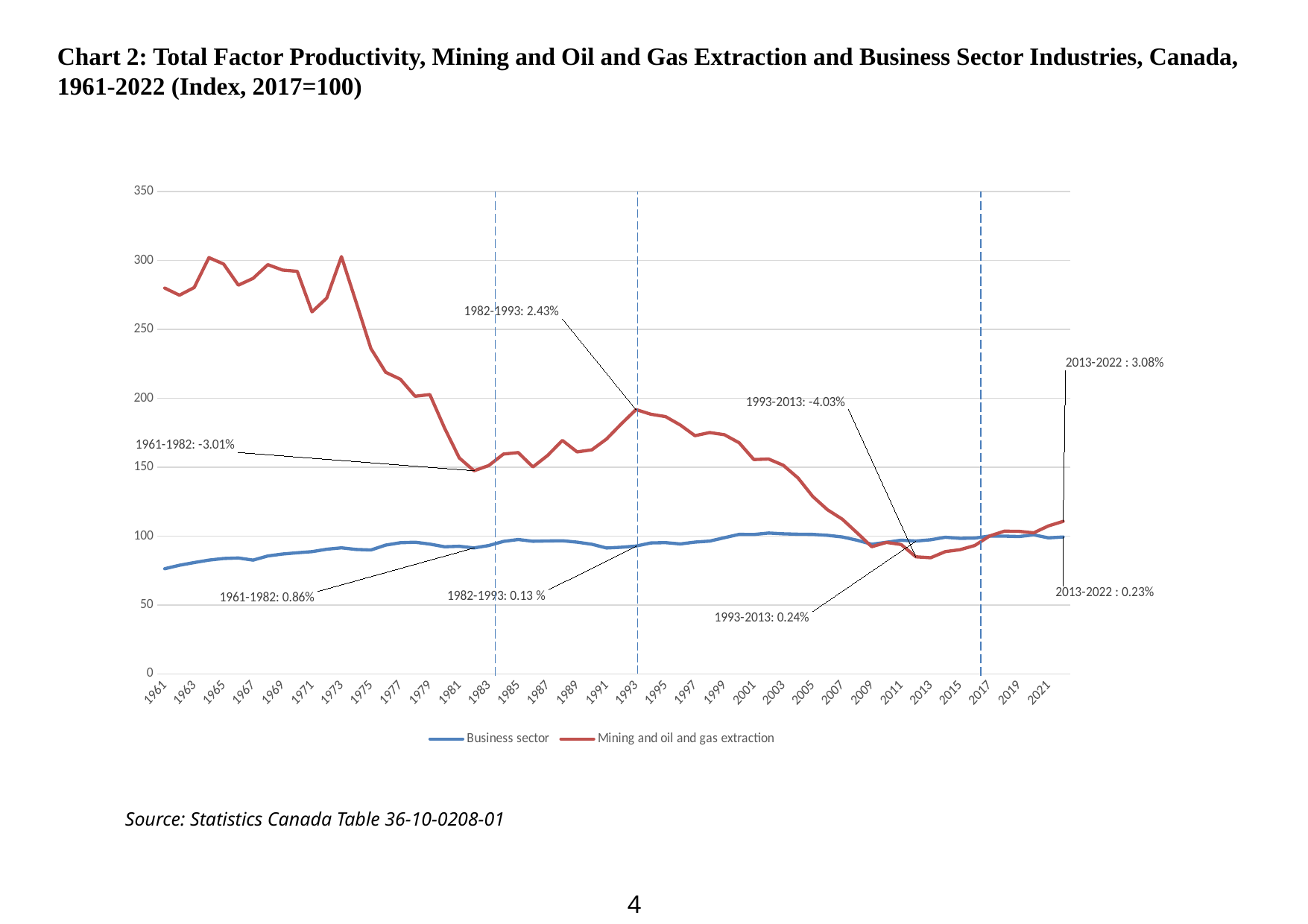
Does the Mining and oil and gas extraction line rise or fall between 1993 and 2013? Fall What growth rate is annotated for Mining and oil and gas extraction for 2013-2022? 3.08% What growth rate is annotated for Mining and oil and gas extraction for 1961-1982? -3.01% Which series has the higher value in 1973, Business sector or Mining and oil and gas extraction? Mining and oil and gas extraction Is the value for Mining and oil and gas extraction in 1961 greater or less than 250? greater What growth rate is annotated for the Business sector for 2013-2022? 0.23% What growth rate is annotated for Mining and oil and gas extraction for 1993-2013? -4.03% What are the two series named in the legend? Business sector; Mining and oil and gas extraction What kind of chart is shown on the slide? Line chart What growth rate is annotated for Mining and oil and gas extraction for 1982-1993? 2.43% How many series does the legend list? 2 What growth rate is annotated for the Business sector for 1961-1982? 0.86%